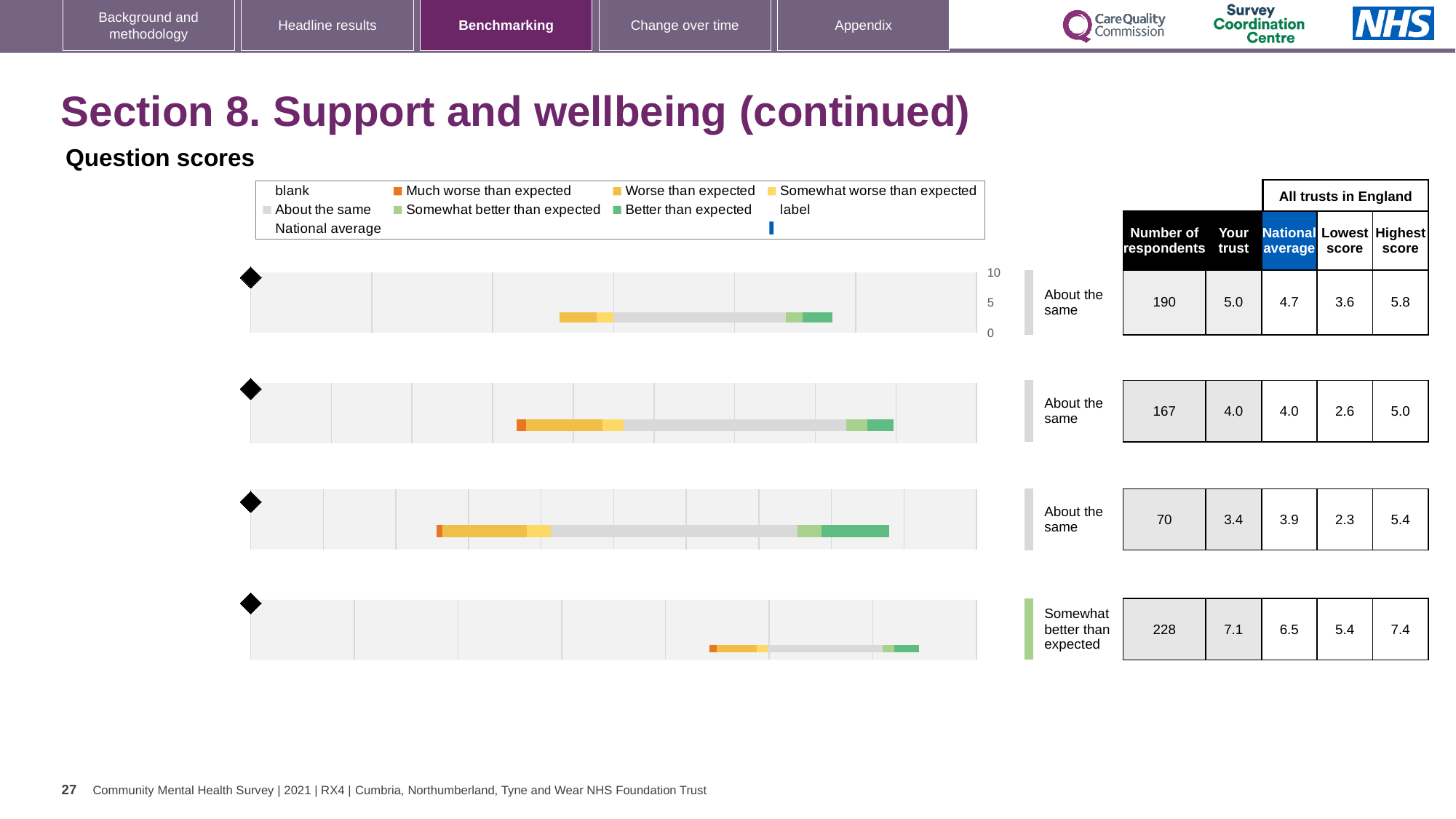
For the bottom (fourth) chart row, what is the difference between the 'Your trust' score and the national average? 0.6 For the bottom (fourth) chart row, what is the highest score among all trusts in England? 7.4 What kind of chart is used for each of the four question rows on the slide? bar chart For the third chart row, what is the lowest score among all trusts in England? 2.3 For the top (first) chart row, what is the number of respondents shown in the table? 190 Which chart row has the highest 'Your trust' score? the bottom (fourth) row, 7.1 Which chart row has the fewest respondents? the third row, 70 For the third chart row, which is larger: the 'Your trust' score or the national average? national average For the top (first) chart row, what is the 'Your trust' score? 5.0 How many question rows (charts) are shown on the slide? 4 What benchmark label is given to the bottom (fourth) chart row? Somewhat better than expected For the second chart row, what is the national average score? 4.0